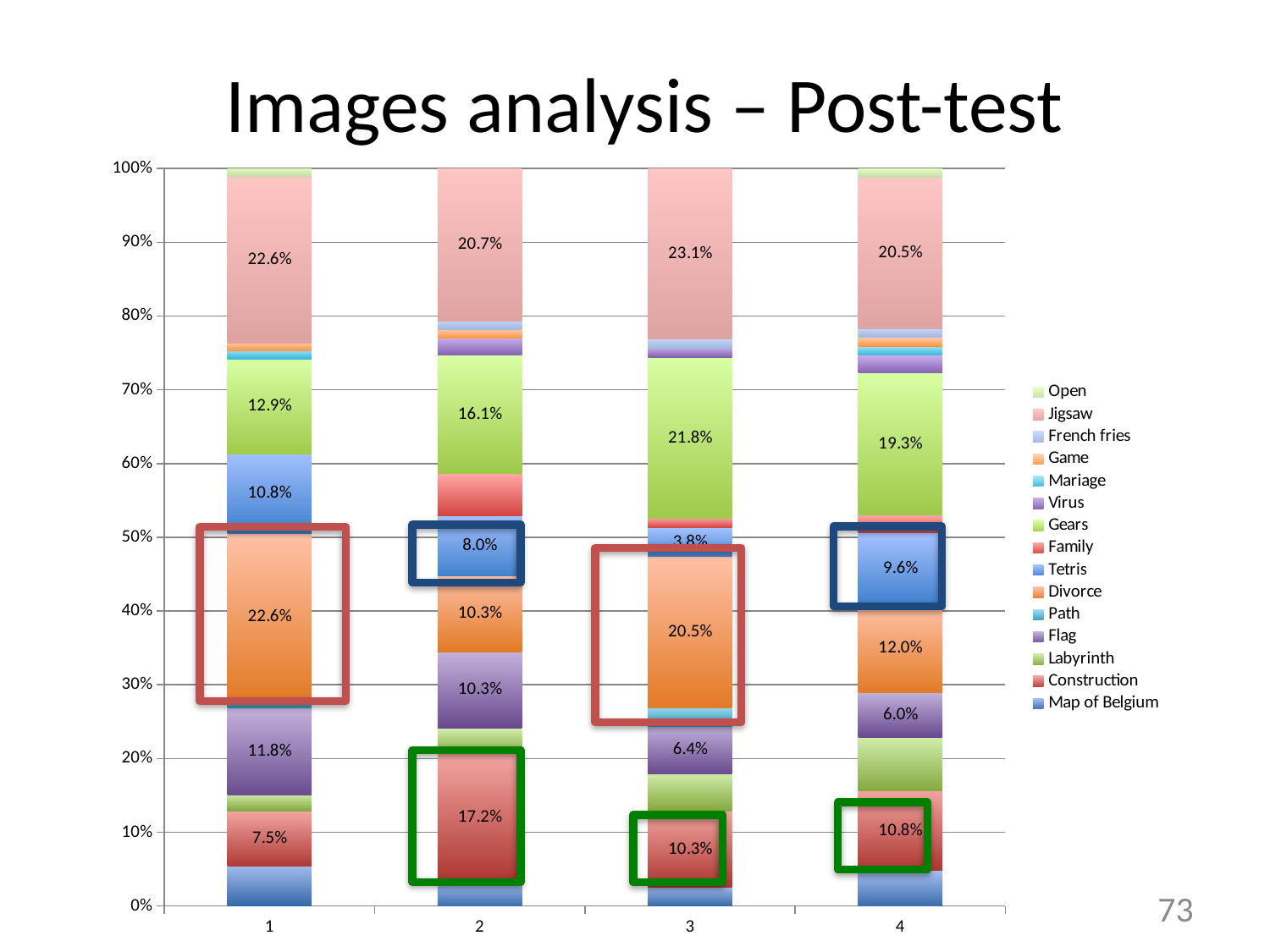
What is the Flag share for category 4? 6.0% What is the Construction share for category 2? 17.2% Which category has the larger Tetris share, 2 or 4? 4 Which category has the highest Gears share? 3 How many categories are shown along the x axis? 4 What is the Jigsaw share for category 3? 23.1% What is the title of the slide? Images analysis – Post-test How many series does the legend list? 15 What kind of chart is shown on the slide? Stacked bar chart What is the difference between the Divorce share in category 1 and in category 4? 10.6 percentage points What is the Divorce share for category 1? 22.6% Which category has the lowest Construction share? 1